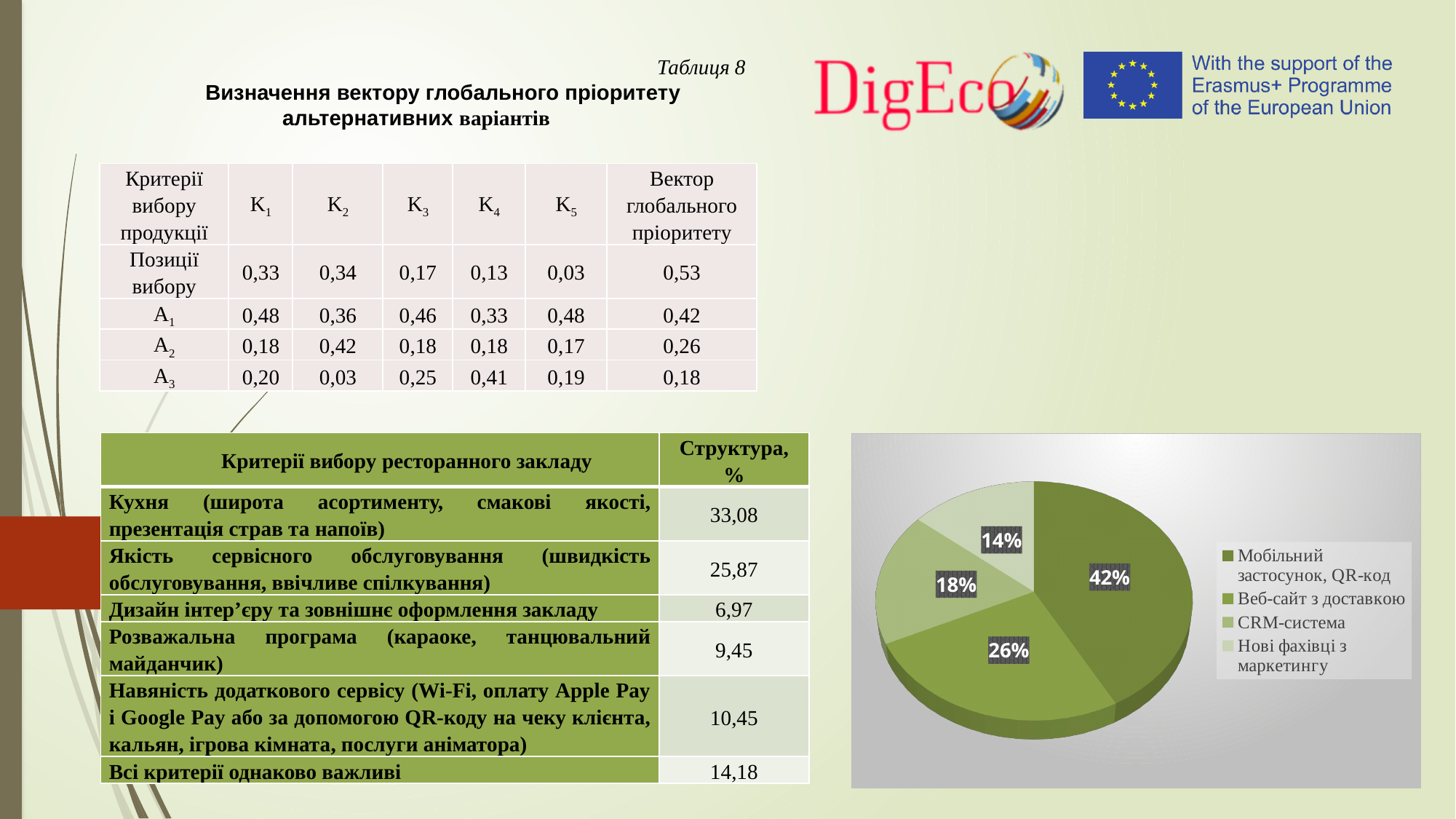
In the pie chart, what share is shown for Мобільний застосунок, QR-код? 42% Which is larger in the pie chart: CRM-система or Нові фахівці з маркетингу? CRM-система What is the combined share of the CRM-система and Нові фахівці з маркетингу slices? 32% In the pie chart, what share is shown for Веб-сайт з доставкою? 26% How many slices does the pie chart have? 4 What is the difference in percentage points between the Мобільний застосунок, QR-код slice and the Веб-сайт з доставкою slice? 16 Which category has the smallest slice in the pie chart? Нові фахівці з маркетингу What kind of chart is shown on the slide? pie chart In the pie chart, what share is shown for Нові фахівці з маркетингу? 14% How many entries does the pie chart legend list? 4 In the pie chart, what share is shown for CRM-система? 18% Which category has the largest slice in the pie chart? Мобільний застосунок, QR-код